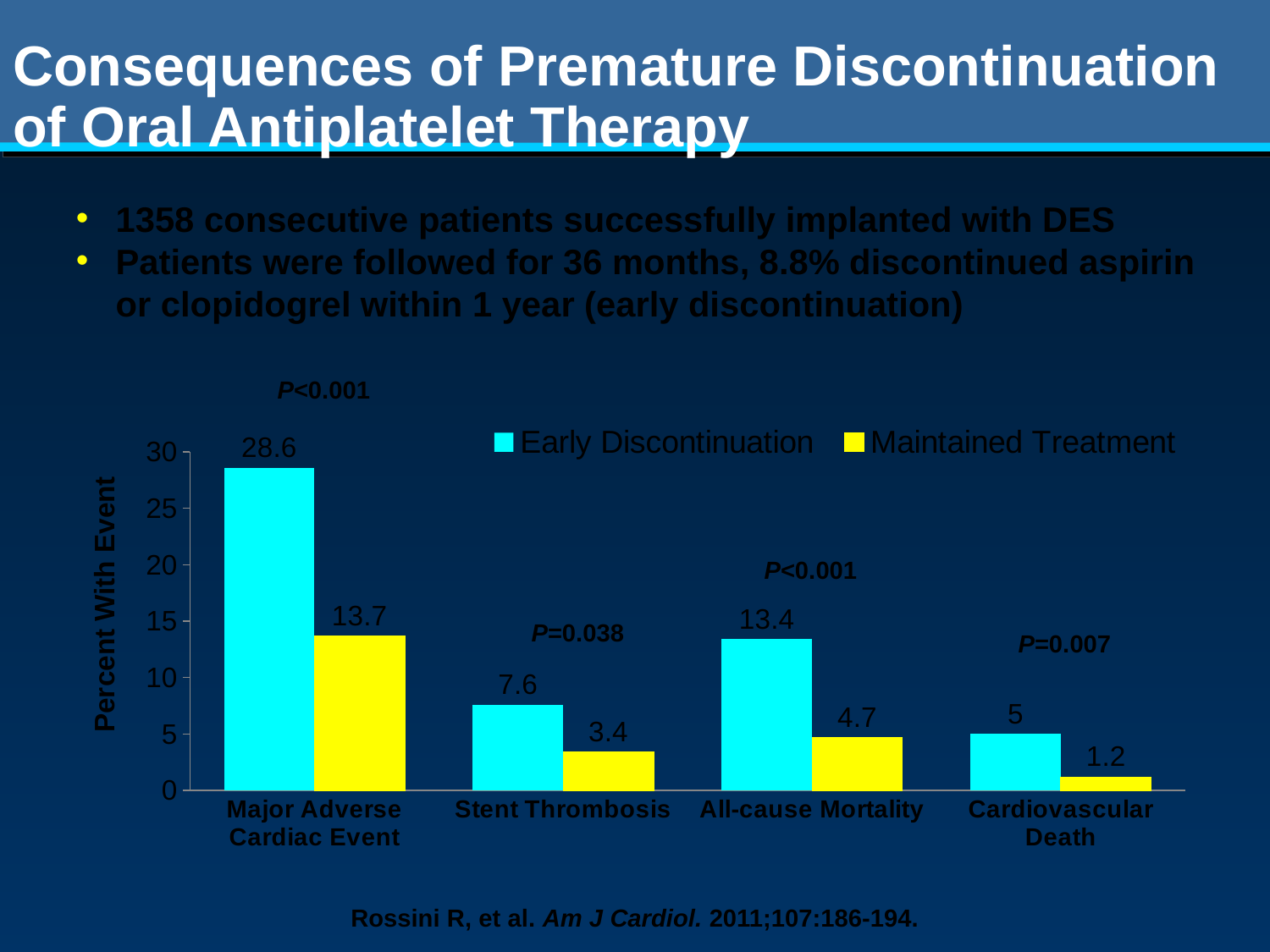
What is the Early Discontinuation value for Major Adverse Cardiac Event? 28.6 Which is larger for All-cause Mortality: the Early Discontinuation value or the Maintained Treatment value? Early Discontinuation What is the label of the y axis? Percent With Event What is the Maintained Treatment value for Cardiovascular Death? 1.2 How many categories are shown on the x axis? 4 How many series does the legend list? 2 What is the Early Discontinuation value for All-cause Mortality? 13.4 Which category has the highest Early Discontinuation value? Major Adverse Cardiac Event What is the difference between the Early Discontinuation and Maintained Treatment values for Major Adverse Cardiac Event? 14.9 What is the Maintained Treatment value for Stent Thrombosis? 3.4 Which category has the lowest Maintained Treatment value? Cardiovascular Death What kind of chart is shown on the slide? Bar chart